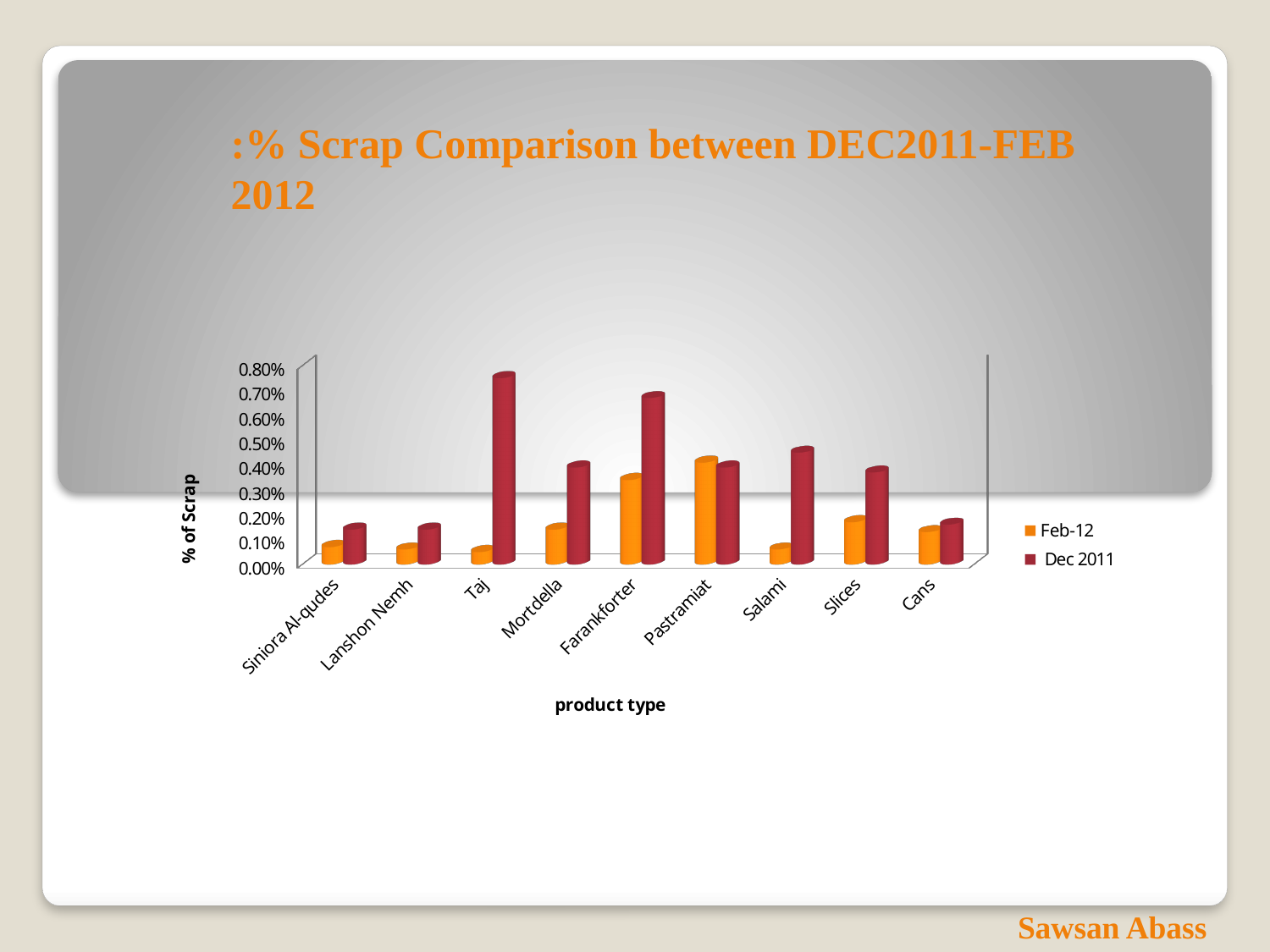
What is the label of the chart's vertical axis? % of Scrap What kind of chart is shown on the slide? Bar chart Which product type has the highest Feb-12 scrap percentage? Pastramiat Which product type has the lowest Feb-12 scrap percentage? Taj Is the Dec 2011 value for Farankforter greater or less than 0.60%? greater Is the Dec 2011 value for Taj greater or less than 0.50%? greater For Taj, which series has the larger value, Feb-12 or Dec 2011? Dec 2011 Is the Feb-12 value for Taj greater or less than 0.10%? less How many product types are shown on the x axis of the chart? 9 How many series does the chart's legend list? 2 What are the two series named in the chart's legend? Feb-12 and Dec 2011 Which product type has the highest Dec 2011 scrap percentage? Taj